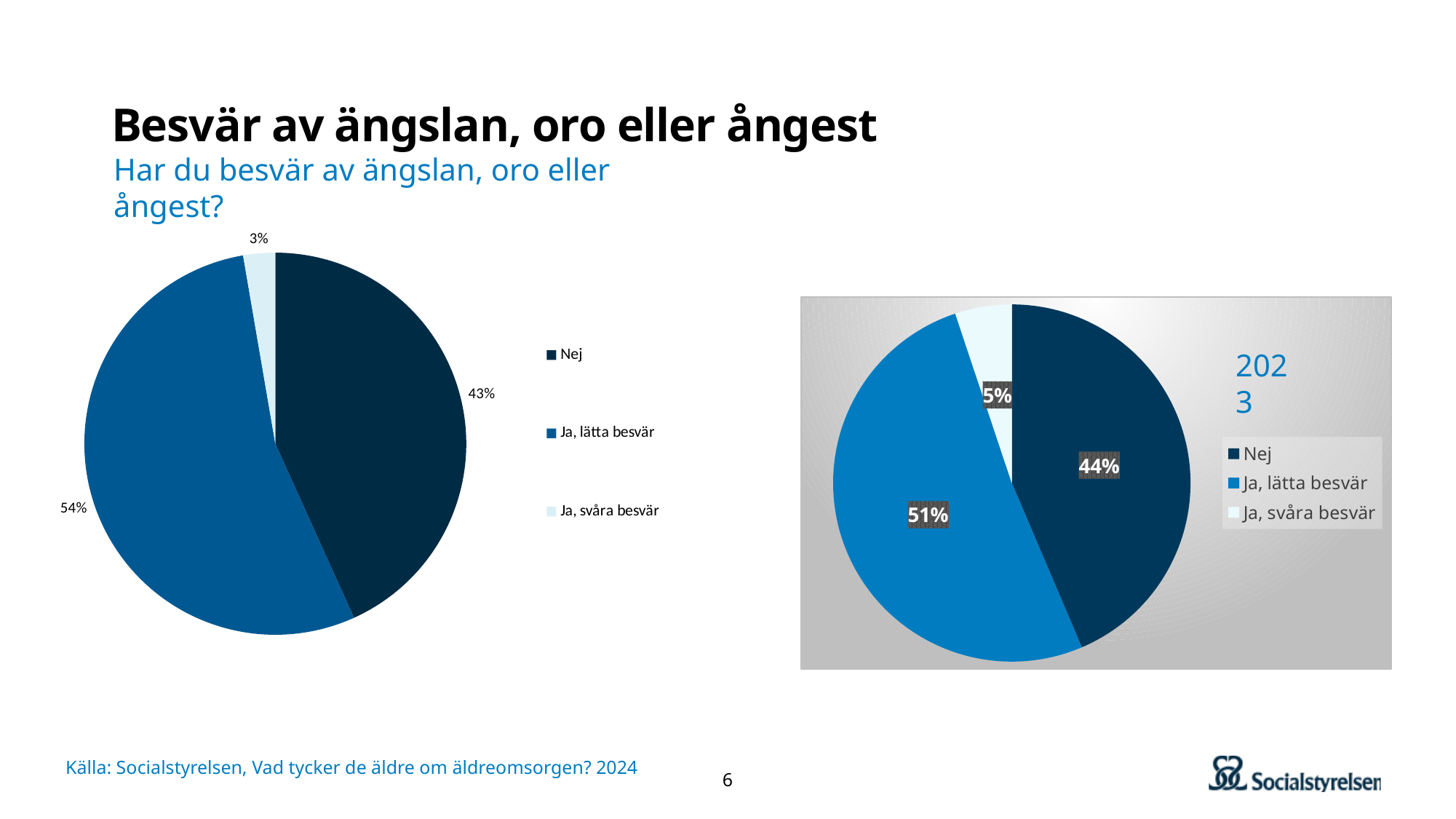
In the right pie chart (2023), what is the value for 'Ja, lätta besvär'? 51% In the right pie chart (2023), what is the value for 'Ja, svåra besvär'? 5% In the left pie chart, which category has the largest share? Ja, lätta besvär What type of chart is shown on the right side of the slide? Pie chart In the left pie chart, what is the value for 'Ja, svåra besvär'? 3% In the left pie chart, what is the value for 'Ja, lätta besvär'? 54% In the right pie chart (2023), which category has the smallest share? Ja, svåra besvär In the left pie chart, what is the difference between 'Ja, lätta besvär' and 'Nej'? 11 percentage points How many categories does the legend of the left pie chart list? 3 In the right pie chart (2023), what is the value for 'Nej'? 44% In the right pie chart (2023), which is larger: 'Nej' or 'Ja, lätta besvär'? Ja, lätta besvär In the left pie chart, what is the value for 'Nej'? 43%